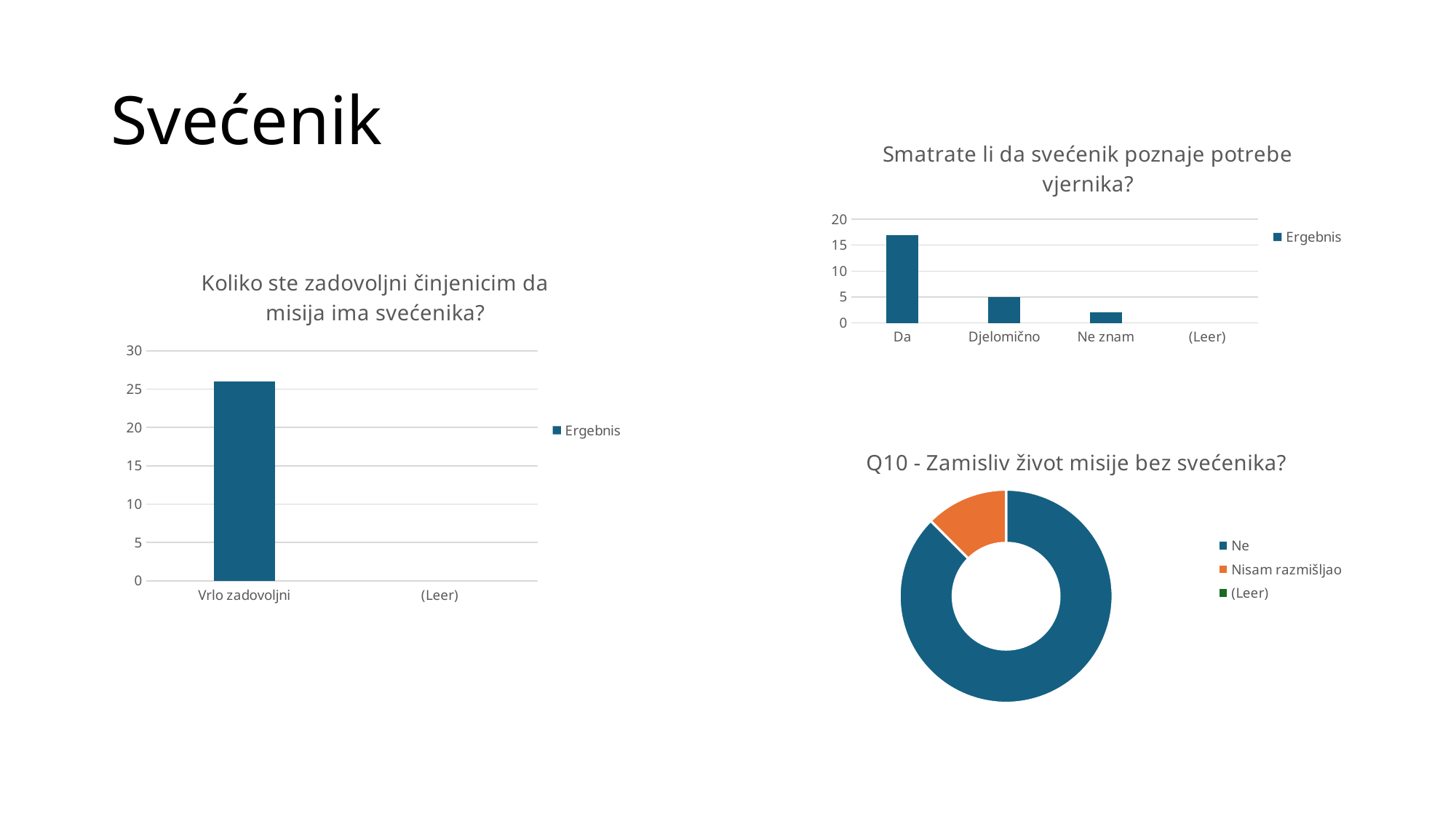
In the chart titled "Smatrate li da svećenik poznaje potrebe vjernika?", is the value for Ne znam greater or less than 5? less In the chart titled "Smatrate li da svećenik poznaje potrebe vjernika?", which category has the highest value? Da In the chart titled "Q10 - Zamisliv život misije bez svećenika?", which category has the largest slice? Ne In the chart titled "Smatrate li da svećenik poznaje potrebe vjernika?", how many categories are shown on the x axis? 4 In the chart titled "Koliko ste zadovoljni činjenicim da misija ima svećenika?", is the value for Vrlo zadovoljni greater or less than 25? greater In the chart titled "Koliko ste zadovoljni činjenicim da misija ima svećenika?", how many series does the legend list? 1 In the chart titled "Koliko ste zadovoljni činjenicim da misija ima svećenika?", what is the name of the series in the legend? Ergebnis In the chart titled "Koliko ste zadovoljni činjenicim da misija ima svećenika?", what kind of chart is shown? bar chart In the chart titled "Q10 - Zamisliv život misije bez svećenika?", what kind of chart is shown? doughnut chart In the chart titled "Smatrate li da svećenik poznaje potrebe vjernika?", what is the value for Djelomično? 5 In the chart titled "Smatrate li da svećenik poznaje potrebe vjernika?", which is larger, Djelomično or Ne znam? Djelomično In the chart titled "Smatrate li da svećenik poznaje potrebe vjernika?", is the value for Da greater or less than 15? greater